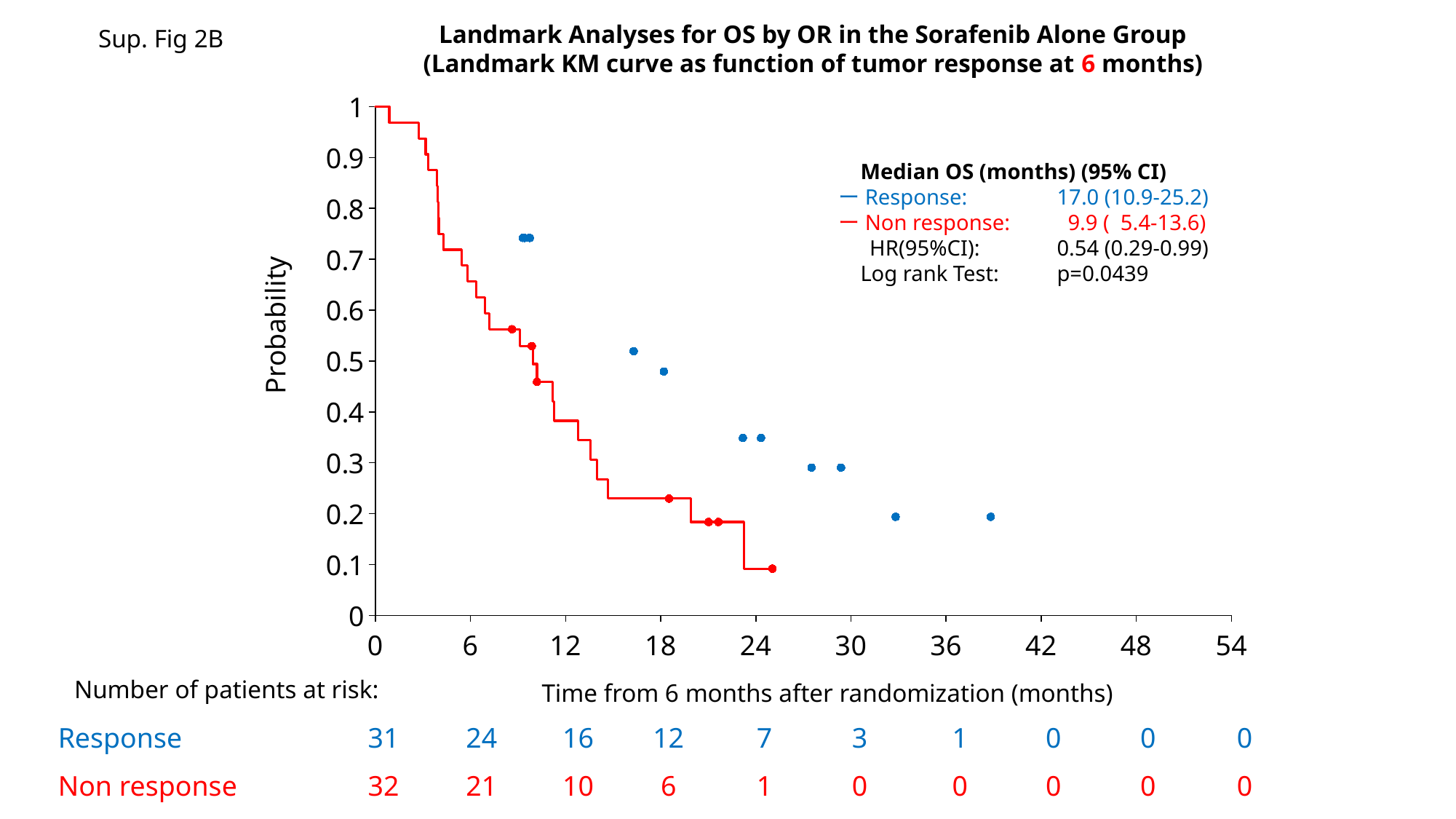
What is the median OS in months for the Non response group? 9.9 What is the label of the x axis? Time from 6 months after randomization (months) What is the difference between the number of Response and Non response patients at risk at 18 months? 6 Is the Non response survival probability at 12 months greater or less than 0.5? less How many Non response patients are at risk at 12 months? 10 What is the 95% CI for the median OS of the Non response group? 5.4-13.6 Which group has more patients at risk at 24 months, Response or Non response? Response What is the hazard ratio (HR) shown on the chart? 0.54 Does the Non response survival curve rise or fall as time increases? fall How many Response patients are at risk at time 0? 31 What is the log rank test p-value shown on the chart? p=0.0439 What is the median OS in months for the Response group? 17.0